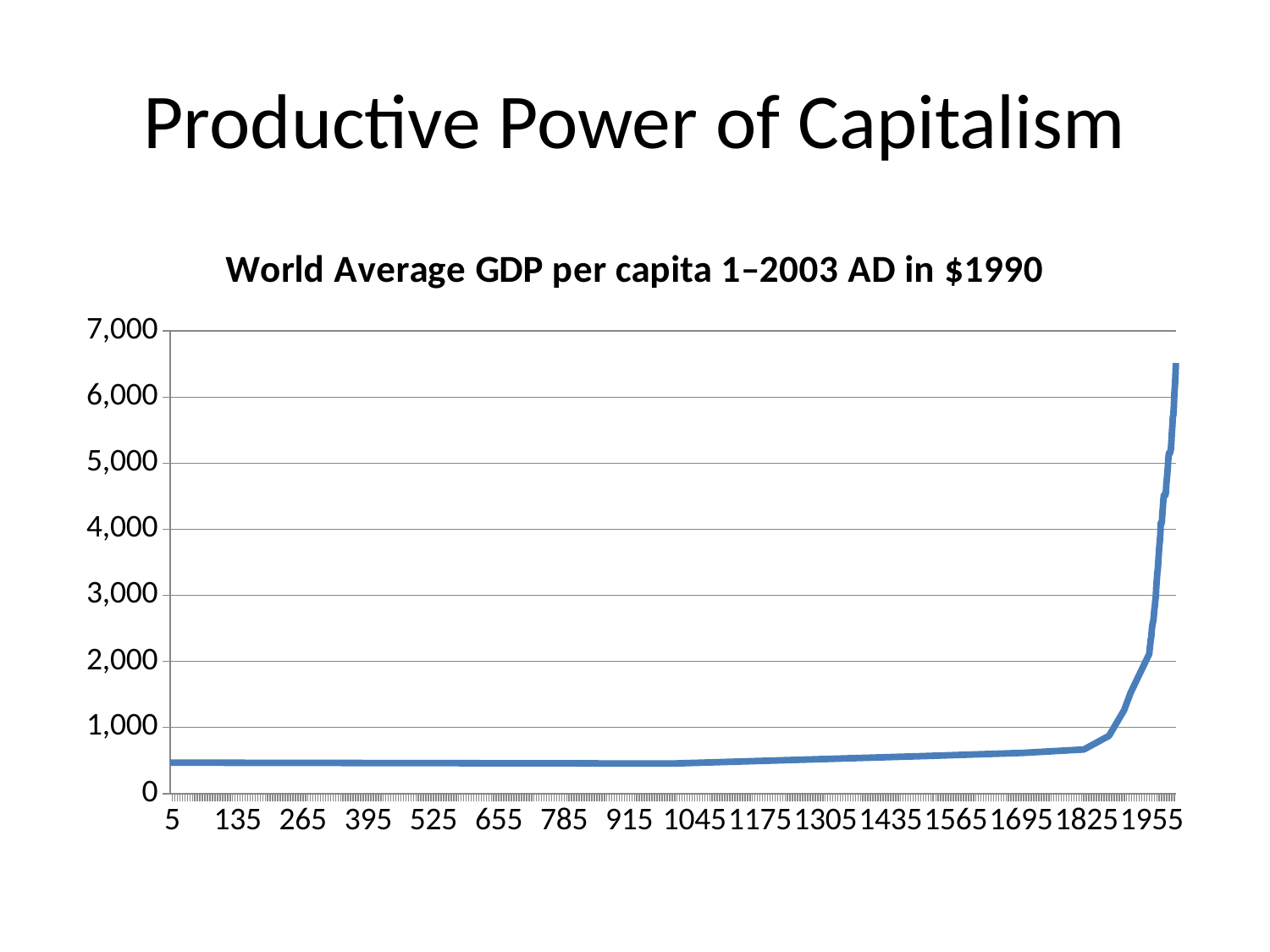
Is the value for 5 greater or less than 1,000? less Is the highest value reached by the line greater or less than 6,000? greater What is the maximum value shown on the vertical axis? 7,000 Is the value for 1825 greater or less than 1,000? less Do the values on the chart generally rise or fall from left to right along the x axis? rise What is the title of the chart? World Average GDP per capita 1–2003 AD in $1990 What kind of chart is shown on the slide? line chart